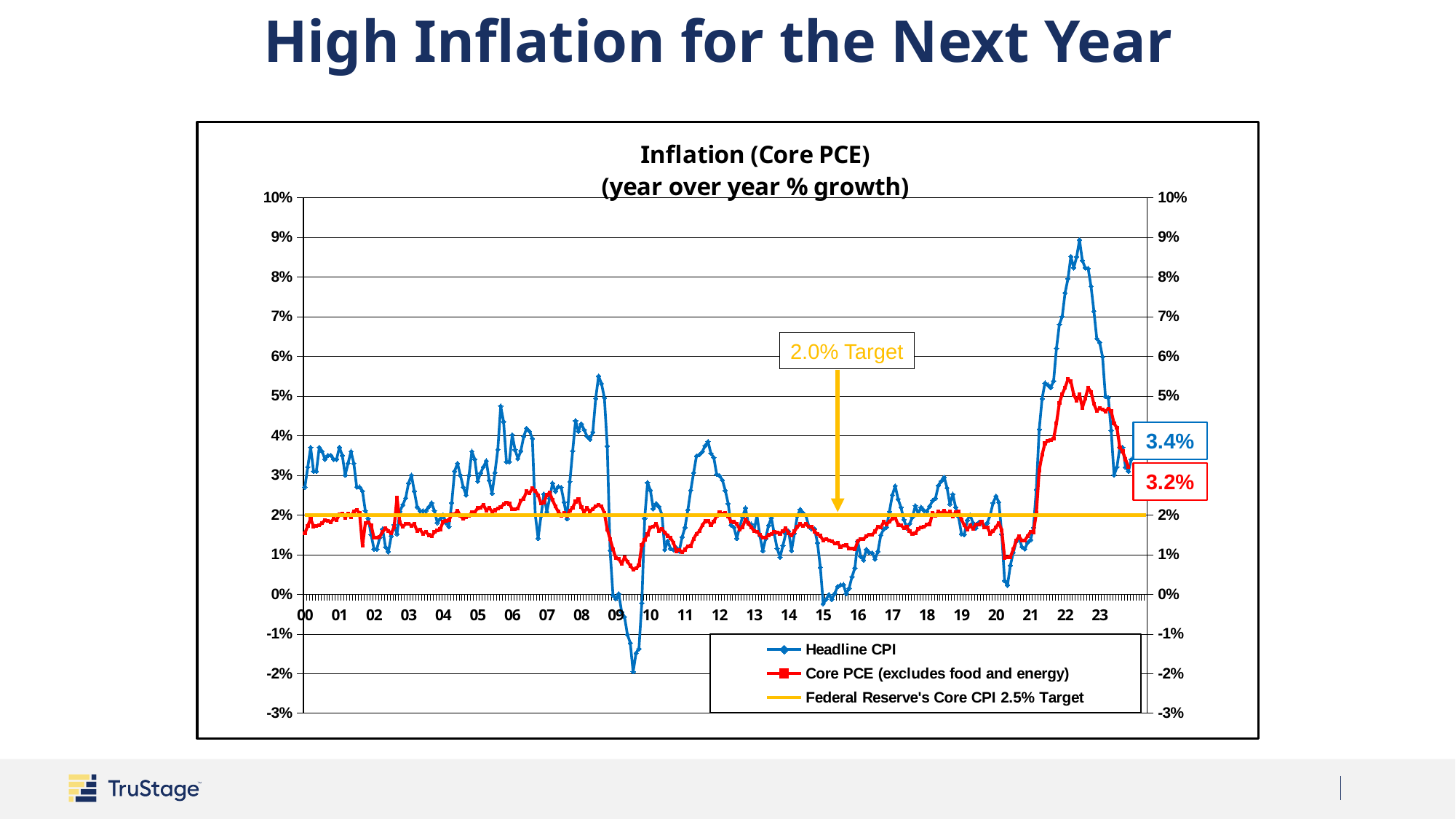
What is the title of the chart? Inflation (Core PCE) (year over year % growth) What does the annotation box pointing to the yellow horizontal line say? 2.0% Target Is the peak value of Core PCE in 2022 greater or less than 5%? greater Which series reaches the highest value anywhere on the chart? Headline CPI Is the peak value of Headline CPI in 2022 greater or less than 8%? greater What kind of chart is shown on the slide? line chart Which is larger at the end of the chart, the labelled Headline CPI value or the labelled Core PCE value? Headline CPI What is the difference between the latest labelled Headline CPI value and the latest labelled Core PCE value? 0.2 percentage points Is the lowest value of Headline CPI around 2009 greater or less than -1%? less How many series does the legend list? 3 What is the latest labelled value for Headline CPI? 3.4% What is the latest labelled value for Core PCE? 3.2%